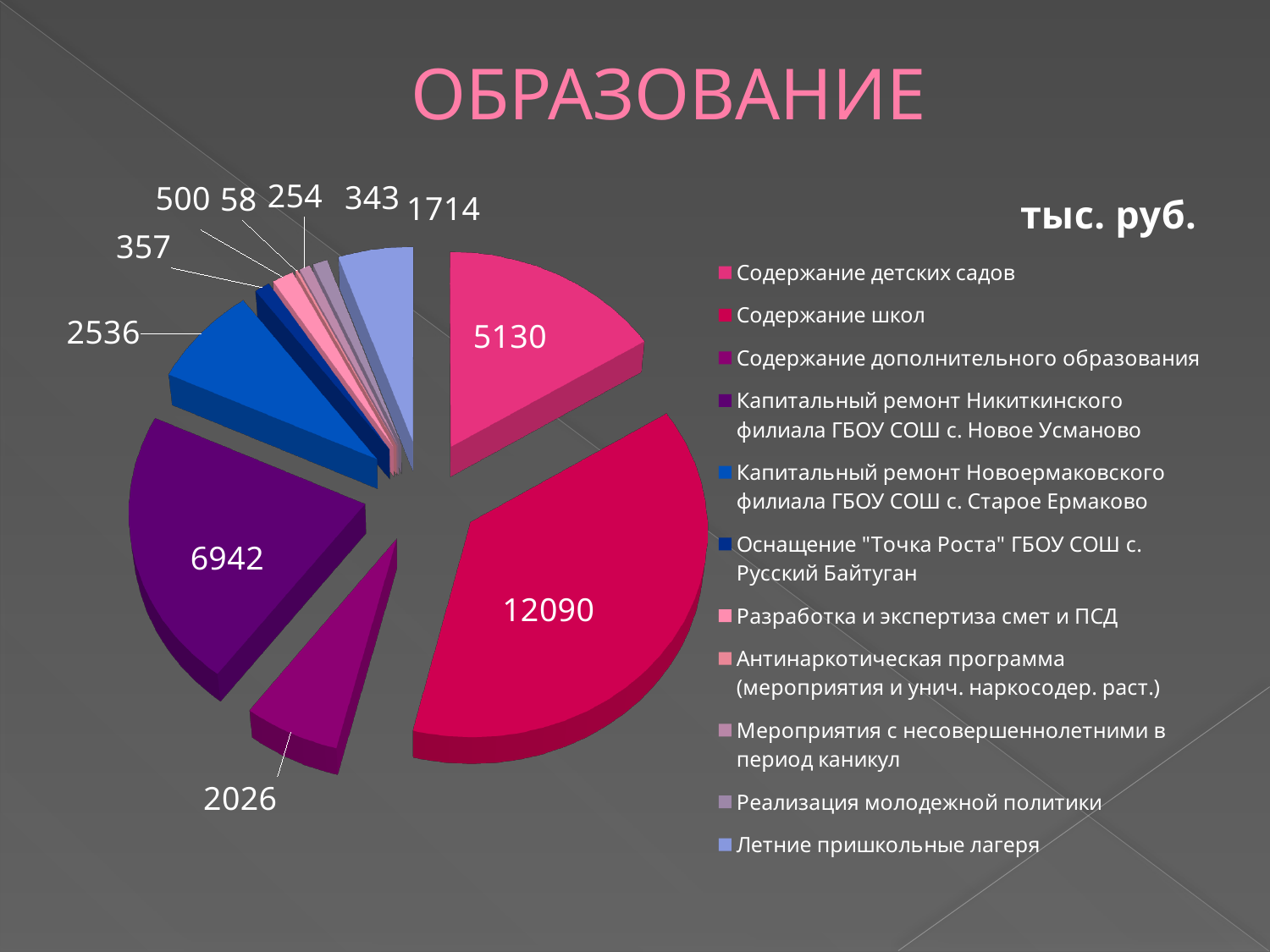
What is the value for Содержание детских садов? 5130 What is the value for Капитальный ремонт Новоермаковского филиала ГБОУ СОШ с. Старое Ермаково? 2536 What is the value for Летние пришкольные лагеря? 1714 Which category has the smallest slice of the pie? Антинаркотическая программа (мероприятия и унич. наркосодер. раст.) What is the value for Содержание школ? 12090 What type of chart is shown on the slide? Pie chart Which is larger: Капитальный ремонт Никиткинского филиала ГБОУ СОШ с. Новое Усманово or Содержание детских садов? Капитальный ремонт Никиткинского филиала ГБОУ СОШ с. Новое Усманово What is the title of the slide? ОБРАЗОВАНИЕ How many categories does the legend list? 11 What is the difference between the values for Содержание школ and Содержание детских садов? 6960 Which category has the largest slice of the pie? Содержание школ What unit is indicated for the values on the chart? тыс. руб.